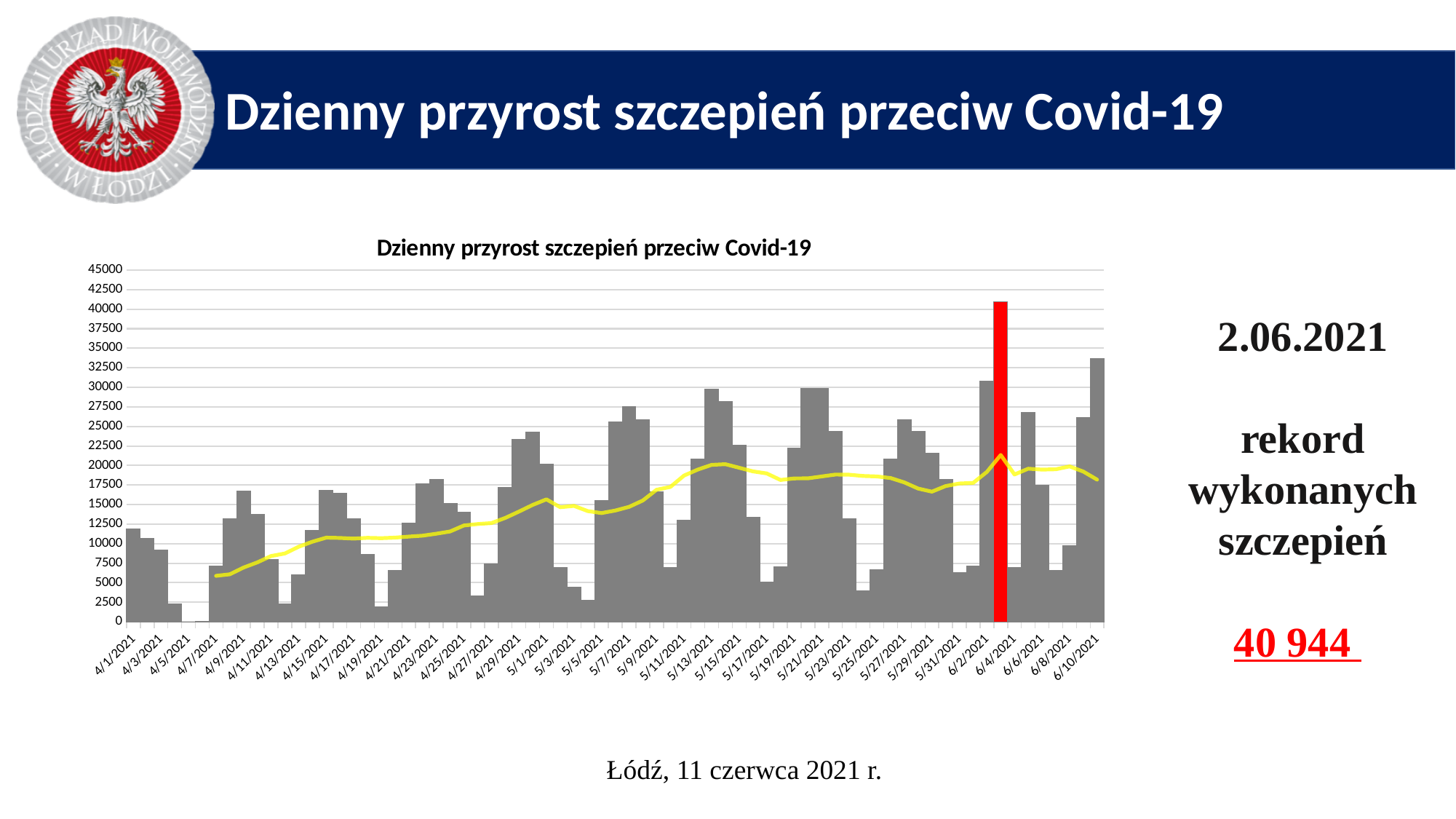
Is the value for 5/13/2021 greater or less than 25000? greater Which is larger, the value for 6/2/2021 or the value for 6/10/2021? 6/10/2021 What is the title of the chart? Dzienny przyrost szczepień przeciw Covid-19 What is the record number of vaccinations shown for 2.06.2021? 40 944 What kind of chart is shown on the slide? bar chart Is the value for 4/1/2021 greater or less than 15000? less Do the daily vaccination values generally rise or fall from April to June 2021? rise Is the value for 4/5/2021 greater or less than 2500? less Which is larger, the value for 4/9/2021 or the value for 4/3/2021? 4/9/2021